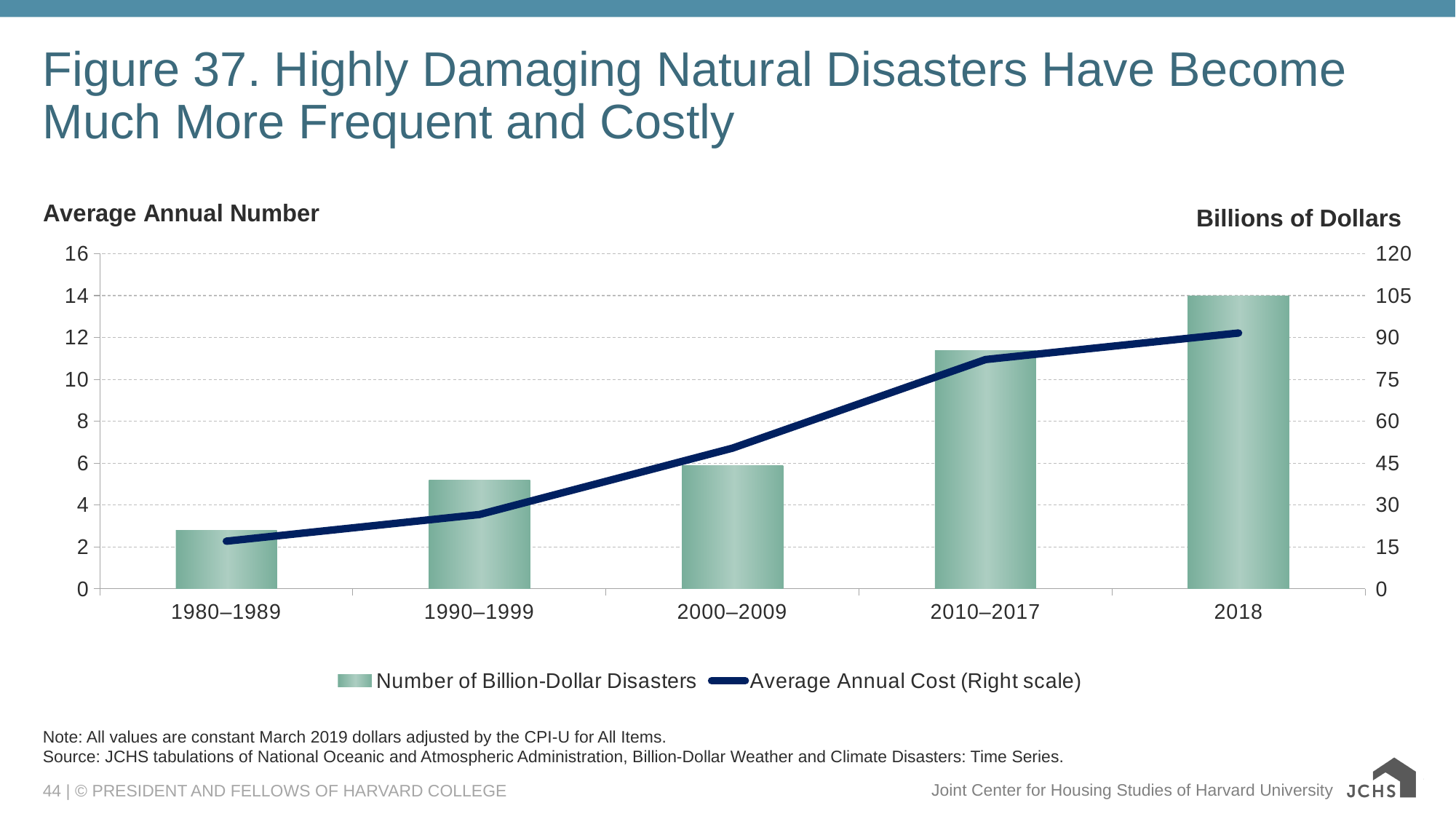
Is the Number of Billion-Dollar Disasters for 2010–2017 greater or less than 10? greater Which period has the highest Number of Billion-Dollar Disasters? 2018 Does the Average Annual Cost rise or fall from 1980–1989 to 2018? Rises Which period has the lowest Number of Billion-Dollar Disasters? 1980–1989 Is the Number of Billion-Dollar Disasters for 1980–1989 greater or less than 4? less What is the label of the right-hand axis? Billions of Dollars Is the Average Annual Cost for 2010–2017 greater or less than 75 billion dollars? greater What type of chart is shown on the slide? Combined bar and line chart How many series does the legend list? 2 How many time periods are shown on the x axis? 5 Which period has a higher Number of Billion-Dollar Disasters, 2000–2009 or 2010–2017? 2010–2017 What is the Number of Billion-Dollar Disasters for 2018? 14